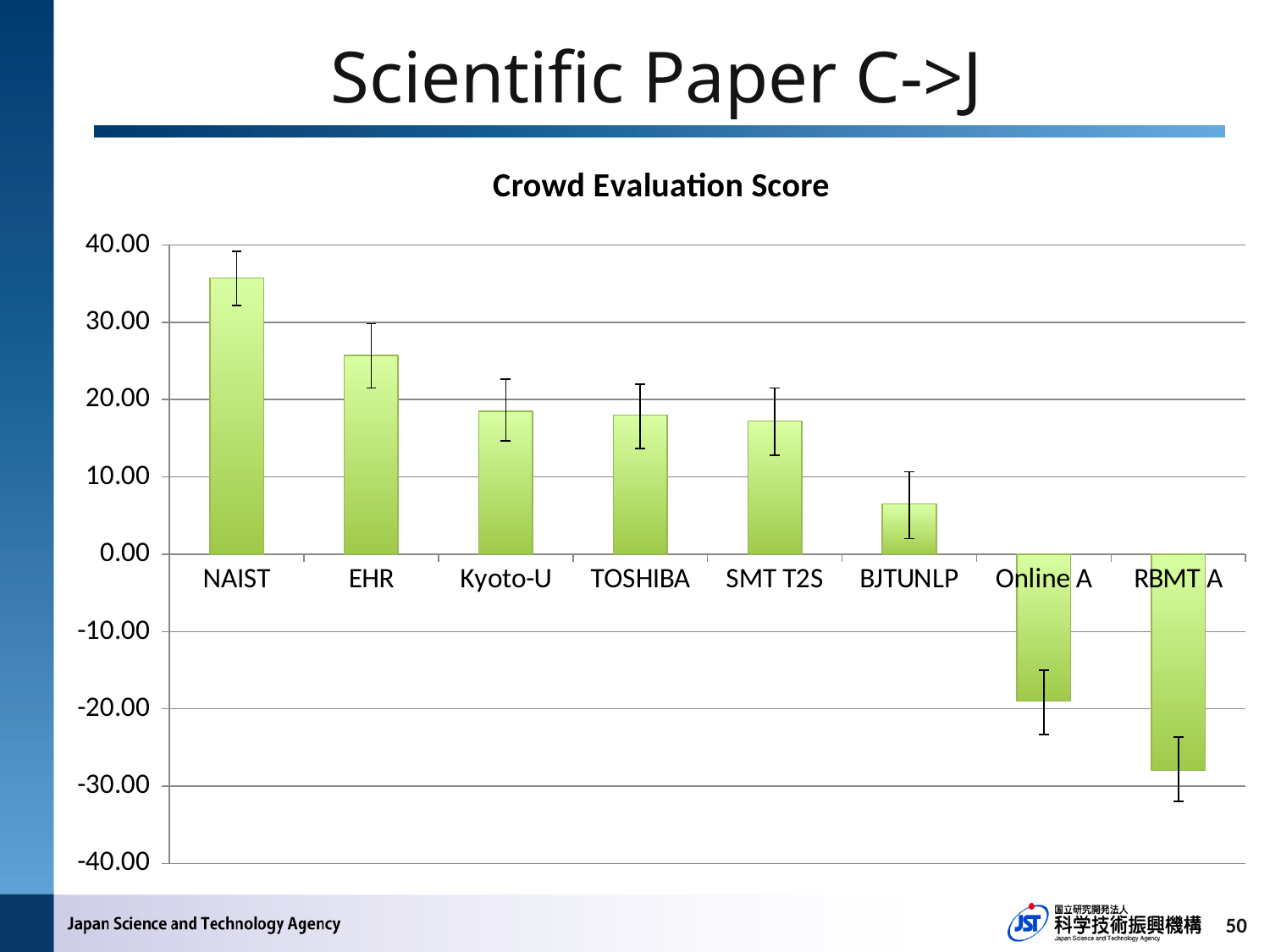
Which category has the highest Crowd Evaluation Score? NAIST Is the value for NAIST greater or less than 30.00? greater Is the value for BJTUNLP greater or less than 10.00? less Do the values generally rise or fall from left to right along the x axis? fall Is the value for EHR greater or less than 20.00? greater What is the title of the chart? Crowd Evaluation Score What kind of chart is shown on the slide? bar chart Which has a larger Crowd Evaluation Score, EHR or SMT T2S? EHR How many categories are shown on the x axis of the chart? 8 Which category has the lowest Crowd Evaluation Score? RBMT A